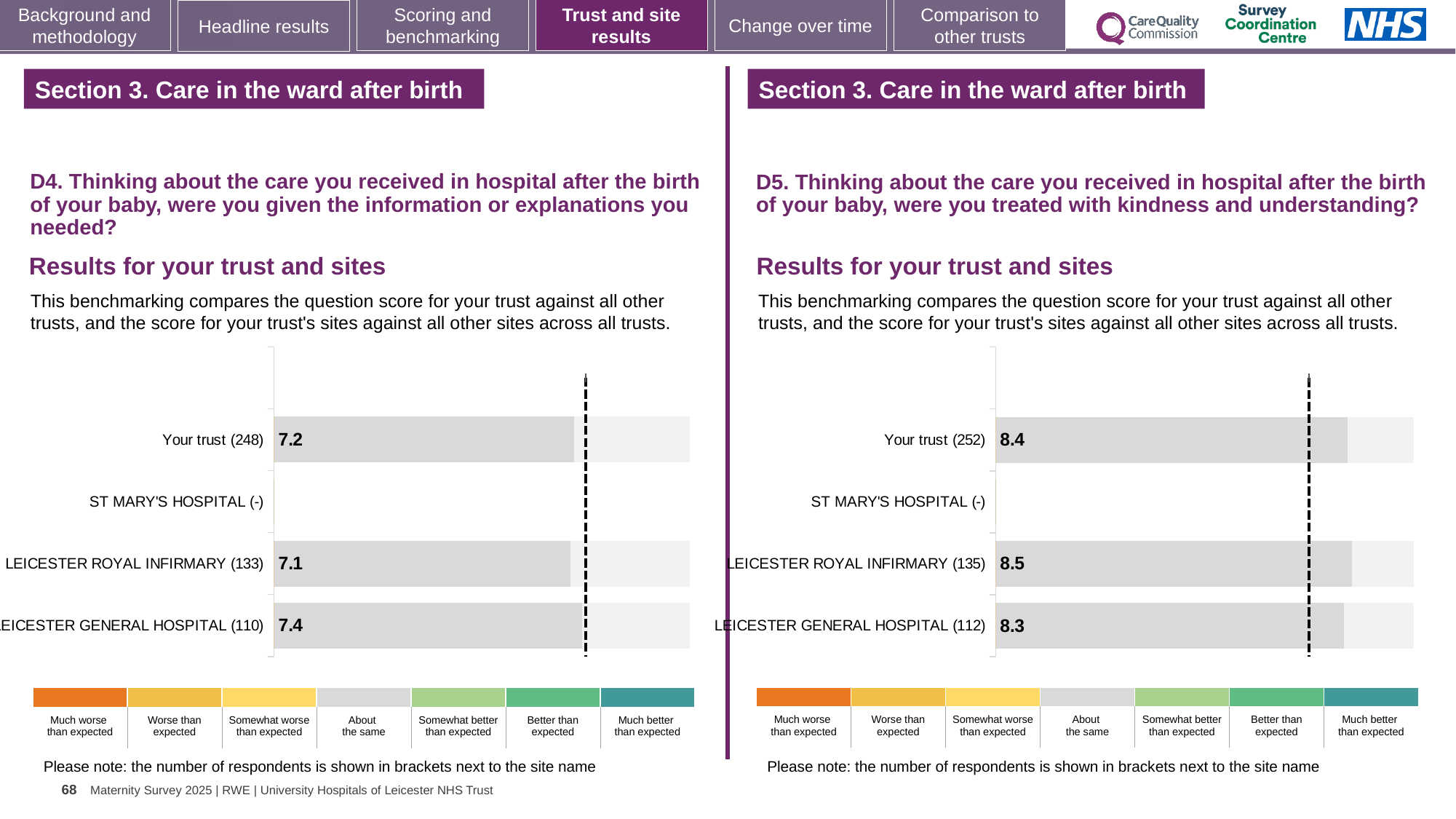
In the D5 chart on the right, what is the difference between the scores for LEICESTER ROYAL INFIRMARY (135) and LEICESTER GENERAL HOSPITAL (112)? 0.2 What kind of chart is the D5 chart on the right? Bar chart In the D5 chart on the right, which site has the highest score? LEICESTER ROYAL INFIRMARY (135) How many categories are listed on the y axis of the D4 chart on the left? 4 In the D4 chart on the left, what is the score for LEICESTER ROYAL INFIRMARY (133)? 7.1 In the D5 chart on the right, which is larger: the score for Your trust (252) or for LEICESTER GENERAL HOSPITAL (112)? Your trust (252) In the D4 chart on the left, which category has no bar plotted? ST MARY'S HOSPITAL (-) In the D5 chart on the right, what is the score for Your trust (252)? 8.4 In the D4 chart on the left, what is the difference between the scores for LEICESTER GENERAL HOSPITAL (110) and LEICESTER ROYAL INFIRMARY (133)? 0.3 In the D4 chart on the left, what is the score for Your trust (248)? 7.2 In the D5 chart on the right, what is the score for LEICESTER GENERAL HOSPITAL (112)? 8.3 In the D4 chart on the left, which site has the highest score? LEICESTER GENERAL HOSPITAL (110)